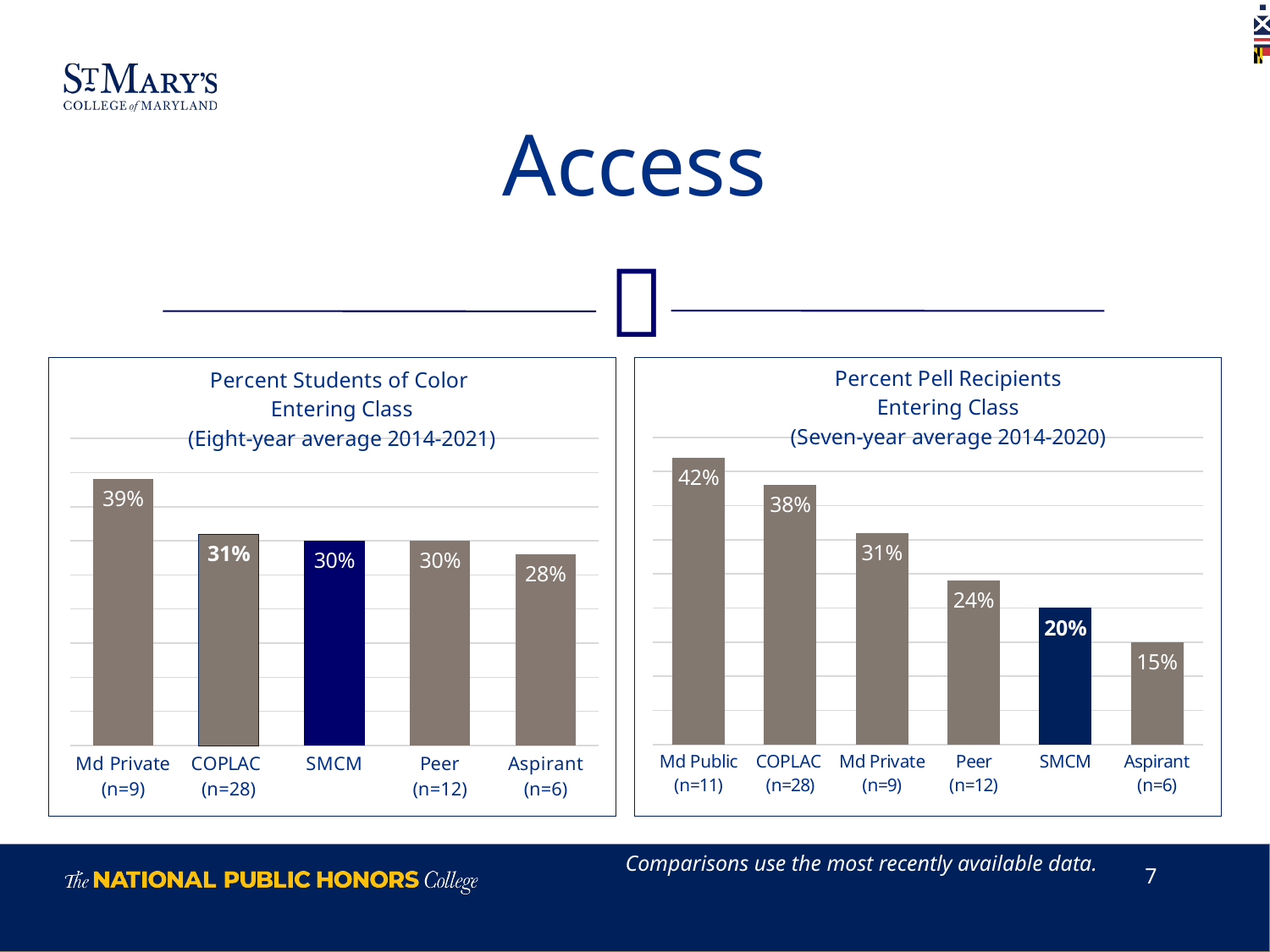
In the 'Percent Pell Recipients Entering Class' chart, which is larger, COPLAC or Peer? COPLAC In the 'Percent Pell Recipients Entering Class' chart, do the values rise or fall from left to right? fall In the 'Percent Students of Color Entering Class' chart, which category has the highest value? Md Private (n=9) In the 'Percent Pell Recipients Entering Class' chart, what is the difference between COPLAC and SMCM? 18% In the 'Percent Pell Recipients Entering Class' chart, which category has the lowest value? Aspirant (n=6) What type of chart is the 'Percent Pell Recipients Entering Class' chart? bar chart In the 'Percent Students of Color Entering Class' chart, what is the difference between Md Private and Aspirant? 11% In the 'Percent Pell Recipients Entering Class' chart, what is the value for SMCM? 20% In the 'Percent Students of Color Entering Class' chart, which category has the lowest value? Aspirant (n=6) In the 'Percent Students of Color Entering Class' chart, how many categories are shown? 5 In the 'Percent Pell Recipients Entering Class' chart, what is the value for Md Public? 42% In the 'Percent Students of Color Entering Class' chart, what is the value for SMCM? 30%